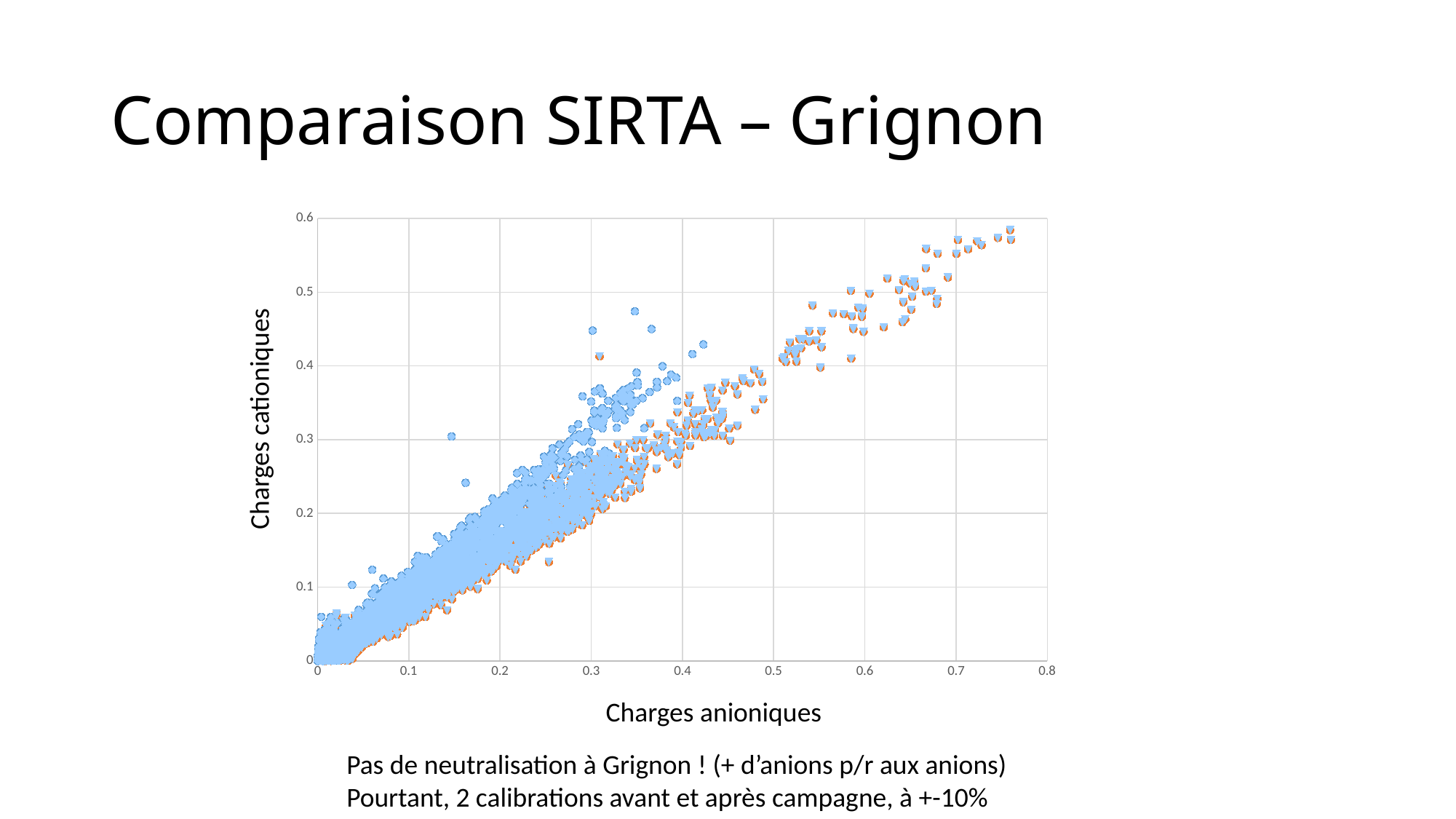
What kind of chart is shown on the slide? scatter chart What is the label of the y axis of the chart? Charges cationiques Do the plotted values of Charges cationiques generally rise or fall as Charges anioniques increases? rise What is the label of the x axis of the chart? Charges anioniques Is the highest plotted Charges anioniques value greater or less than 0.7? greater Is the highest plotted Charges cationiques value greater or less than 0.6? less Is the highest plotted Charges cationiques value greater or less than 0.5? greater